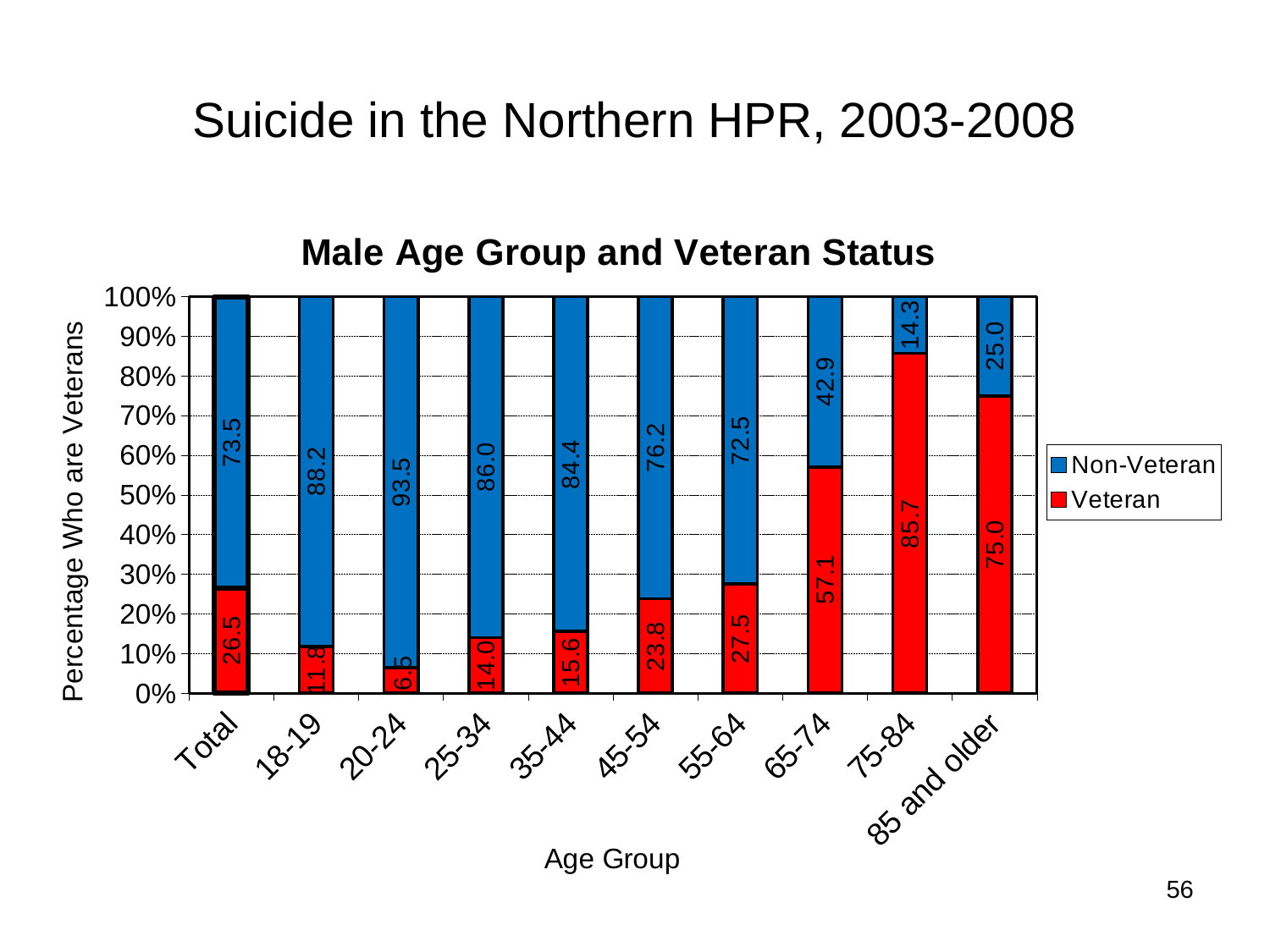
Which age group has the highest Veteran value? 75-84 How many series does the legend list? 2 What is the Veteran value for the 65-74 age group? 57.1 Is the Veteran value for 85 and older greater or less than 50%? greater What is the title of the chart? Male Age Group and Veteran Status What kind of chart is shown? stacked bar chart Which age group has the lowest Veteran value? 20-24 Which is larger, the Veteran value for 45-54 or for 35-44? 45-54 What is the difference between the Non-Veteran values for 18-19 and 55-64? 15.7 How many age group categories are shown on the x axis? 10 What is the Non-Veteran value for the 20-24 age group? 93.5 What is the Veteran value for the Total category? 26.5